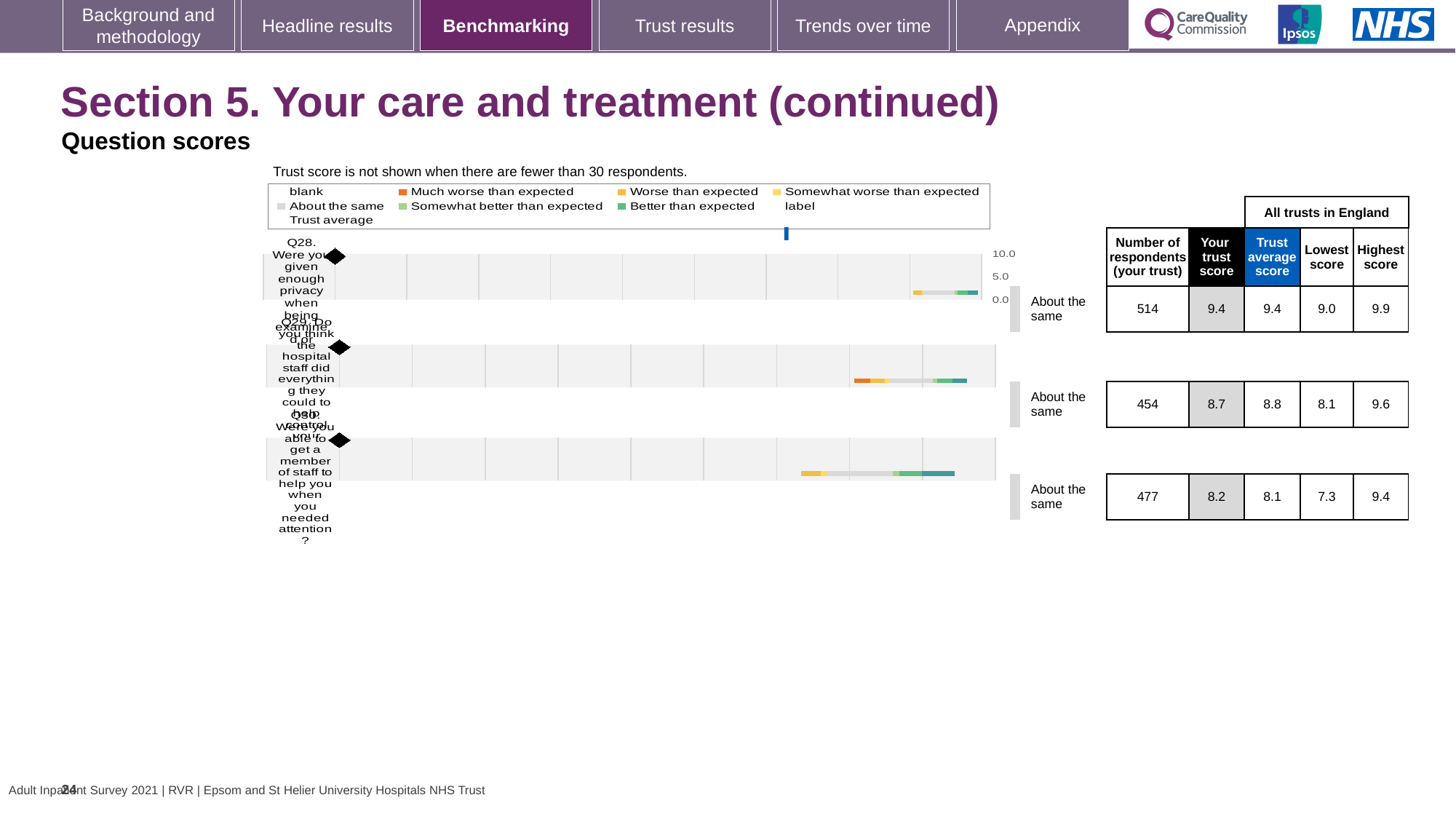
What is the difference between the trust average score and the trust score for Q29? 0.1 What is the trust average score across all trusts in England for Q30 (Were you able to get a member of staff to help you when you needed attention?)? 8.1 Which of the three questions shown has the lowest trust score? Q30 Is the trust score for Q28 or the trust score for Q30 larger? Q28 What kind of chart is used to show the question scores? bar chart Is the trust score for Q29 greater or less than 5.0? greater What is the trust score for Q28 (Were you given enough privacy when being examined or treated?)? 9.4 How many respondents from the trust answered Q29 (Do you think the hospital staff did everything they could to help control your pain?)? 454 How many questions are plotted on this slide? 3 What is the difference between the highest score and the lowest score for Q30? 2.1 Which of the three questions shown has the highest trust score? Q28 What benchmark category is shown for Q29? About the same